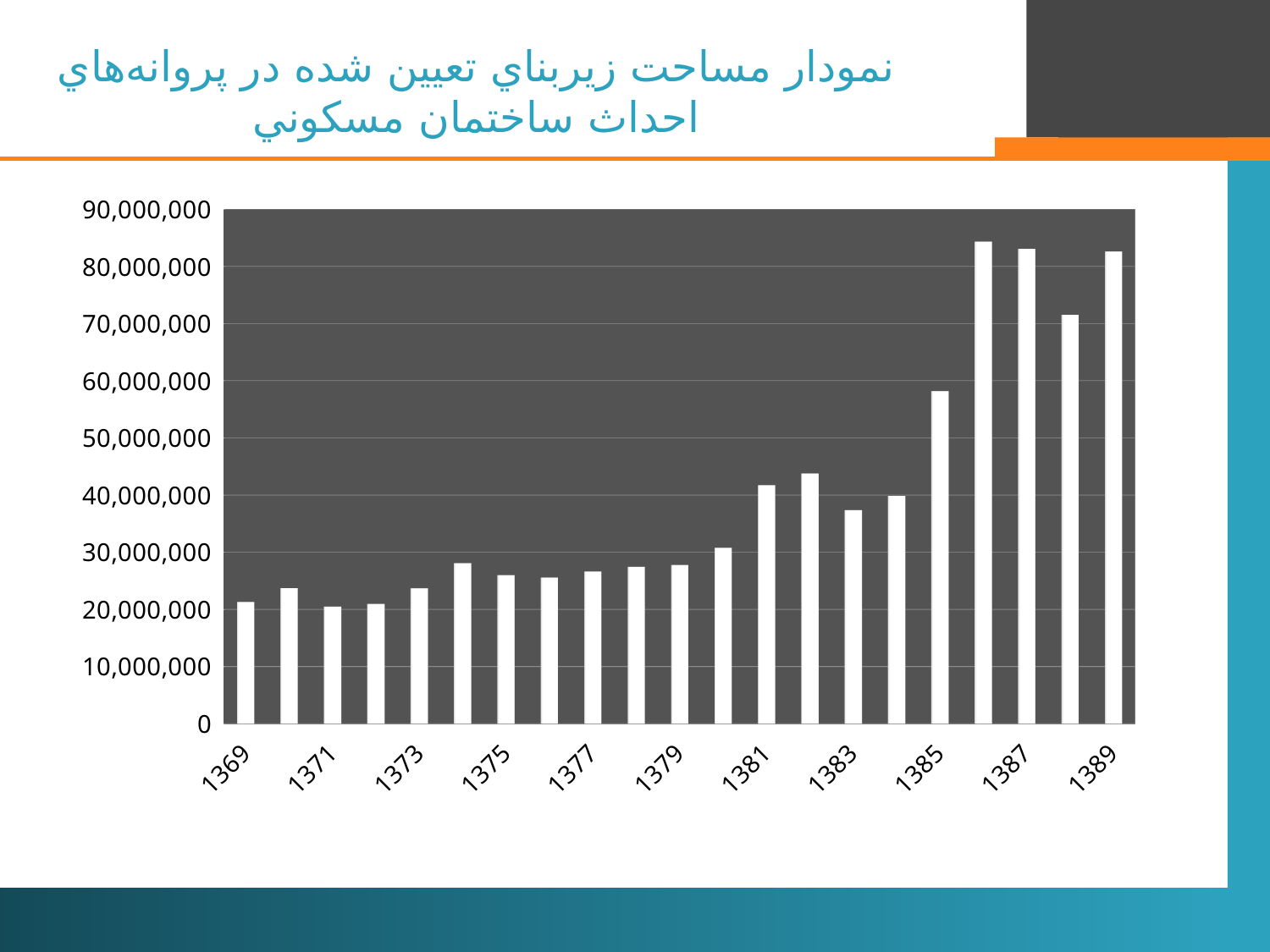
Which has the larger value, 1385 or 1381? 1385 Is the value for 1388 greater or less than 60,000,000? greater Is the value for 1381 greater or less than 40,000,000? greater What is the highest value shown on the y axis? 90,000,000 How many bars (years) are plotted in the chart? 21 What kind of chart is shown on the slide? bar chart Is the value for 1383 greater or less than 40,000,000? less Overall, do the values rise or fall from 1369 to 1389? rise Which has the larger value, 1387 or 1388? 1387 What is the first year shown on the x axis? 1369